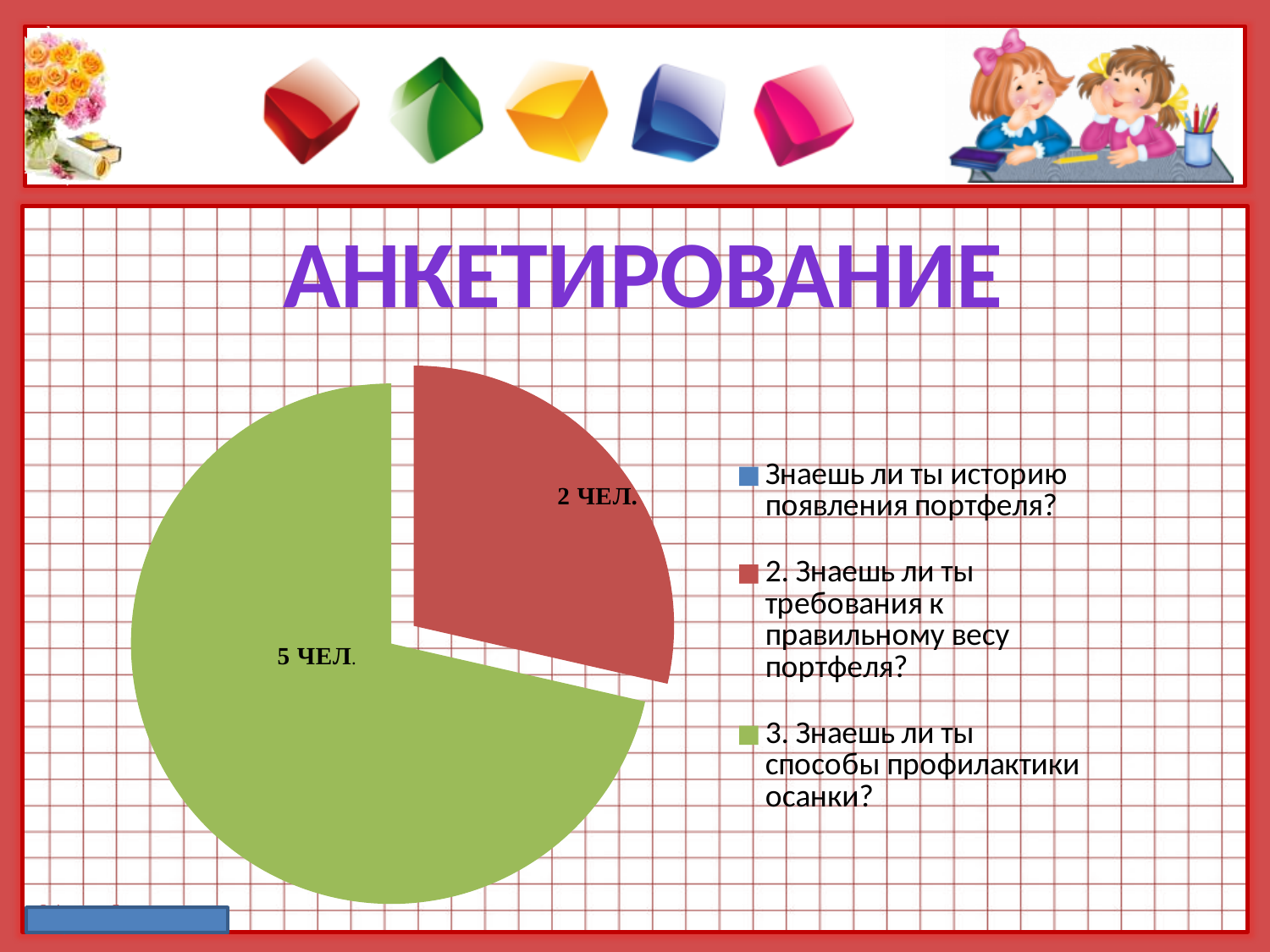
How many slices with data labels are visible in the pie chart? 2 Which slice is larger: the red one or the green one? the green one Which legend entry corresponds to the largest slice of the pie chart? 3. Знаешь ли ты способы профилактики осанки? Which colour in the legend represents the question "Знаешь ли ты историю появления портфеля?"? blue What kind of chart is shown on the slide? pie chart What is the title of the slide above the chart? АНКЕТИРОВАНИЕ What value is labelled on the green slice of the pie chart? 5 ЧЕЛ. What value is labelled on the red slice of the pie chart? 2 ЧЕЛ. Which of the two labelled slices is the smallest? 2 ЧЕЛ. (2. Знаешь ли ты требования к правильному весу портфеля?) How many entries does the legend of the pie chart list? 3 What is the difference between the green slice value and the red slice value? 3